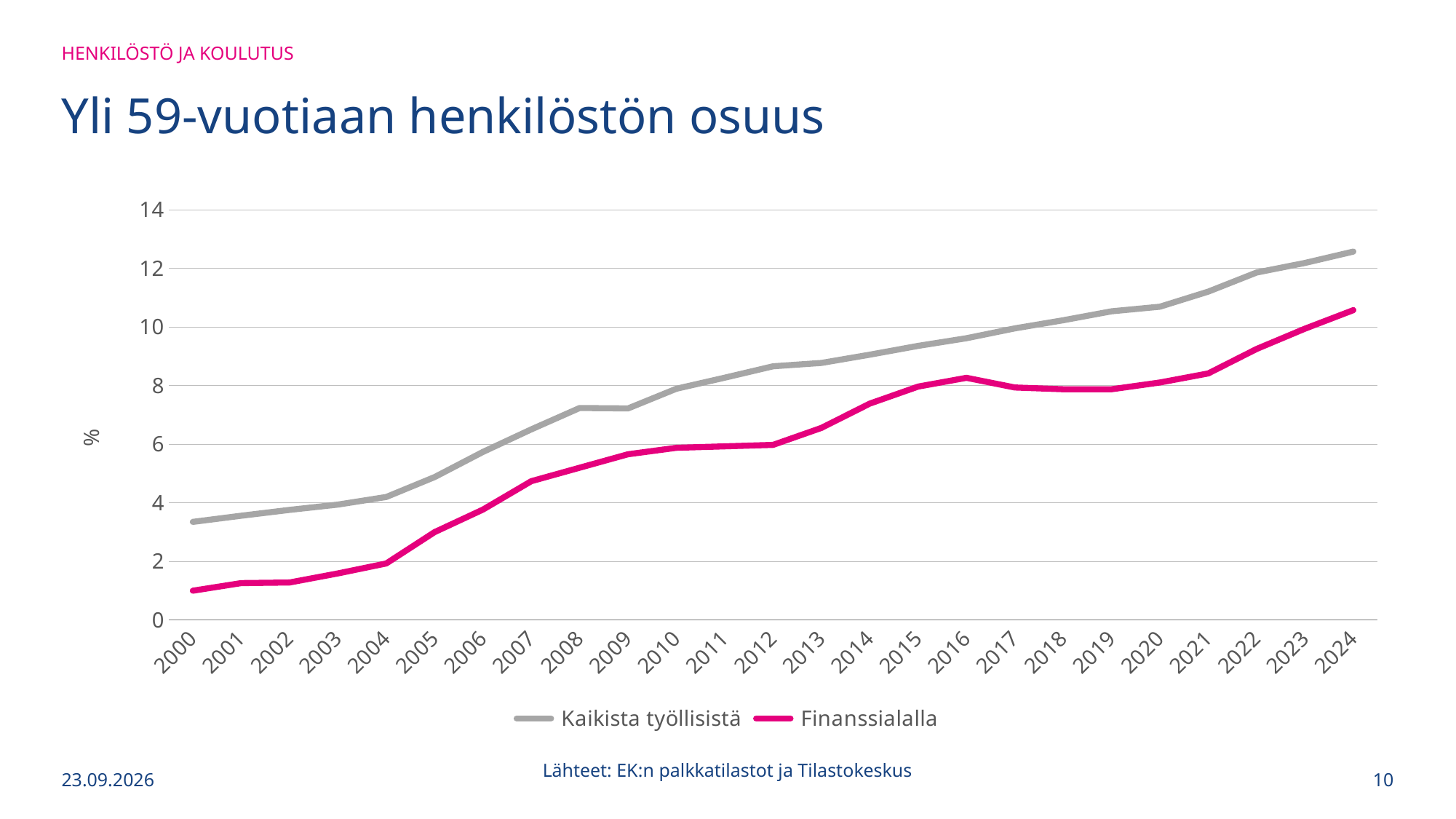
How many series does the legend list? 2 Is the value for Finanssialalla in 2000 greater or less than 2? less Does the Kaikista työllisistä line generally rise or fall from 2000 to 2024? rise Is the value for Kaikista työllisistä in 2024 greater or less than 12? greater Is the value for Finanssialalla in 2024 greater or less than 10? greater What is the title of the chart? Yli 59-vuotiaan henkilöstön osuus What kind of chart is shown on the slide? line chart How many years are shown on the x axis? 25 In 2024, which series has the higher value, Kaikista työllisistä or Finanssialalla? Kaikista työllisistä In which year does the Finanssialalla line reach its highest value? 2024